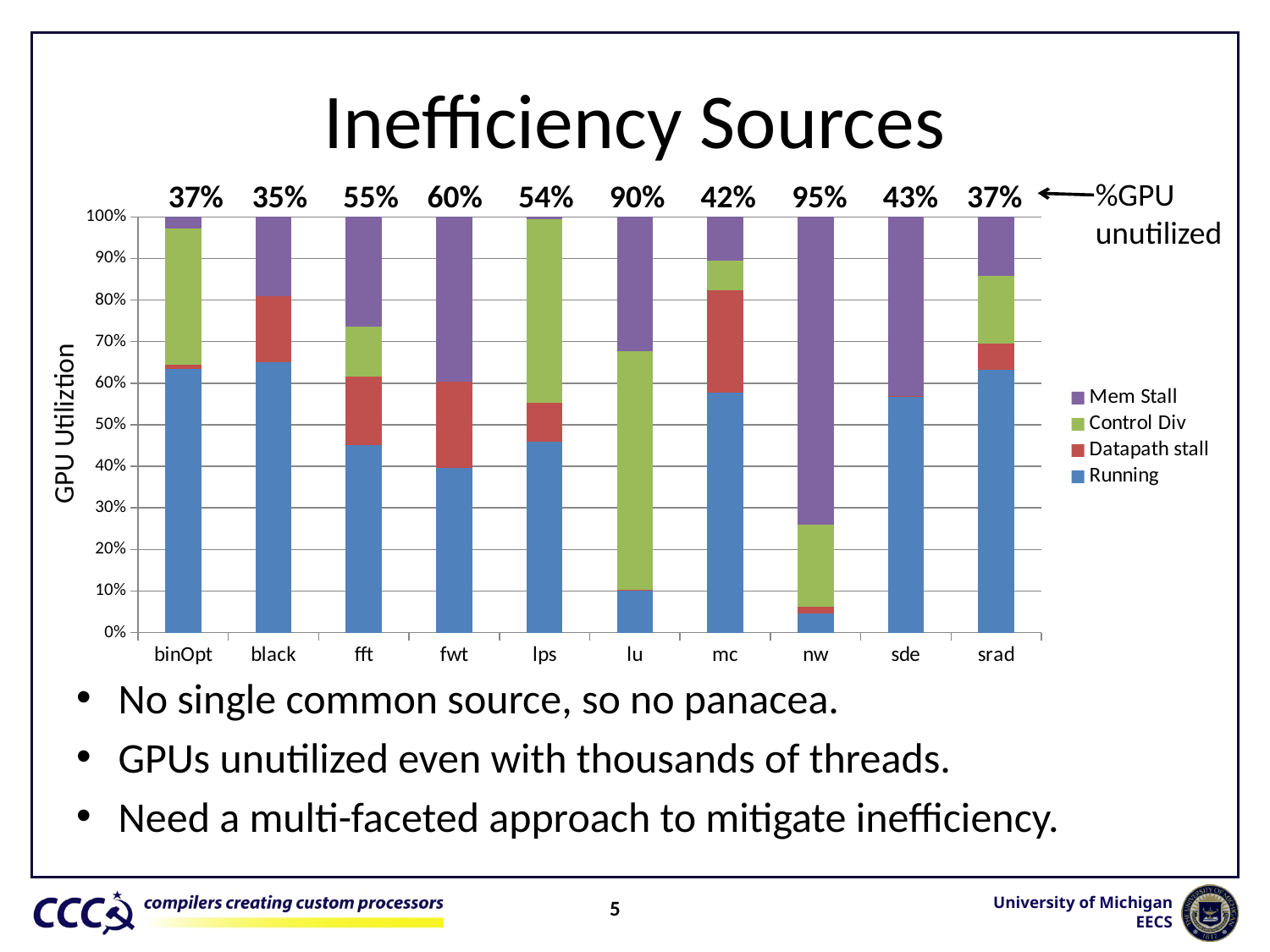
What is the %GPU unutilized value shown above the bar for nw? 95% What is the difference between the %GPU unutilized values for nw and lu? 5% Which legend entry is shown in purple? Mem Stall Is the Running portion of the black bar greater or less than 60%? greater How many categories are shown on the x axis of the chart? 10 How many series does the chart legend list? 4 Which category has the highest %GPU unutilized value printed above its bar? nw What is the %GPU unutilized value shown above the bar for fwt? 60% What kind of chart is shown on the slide? Stacked bar chart Is the Running portion of the lu bar greater or less than 20%? less Which category has the lowest %GPU unutilized value printed above its bar? black Which has a larger %GPU unutilized value, lu or mc? lu